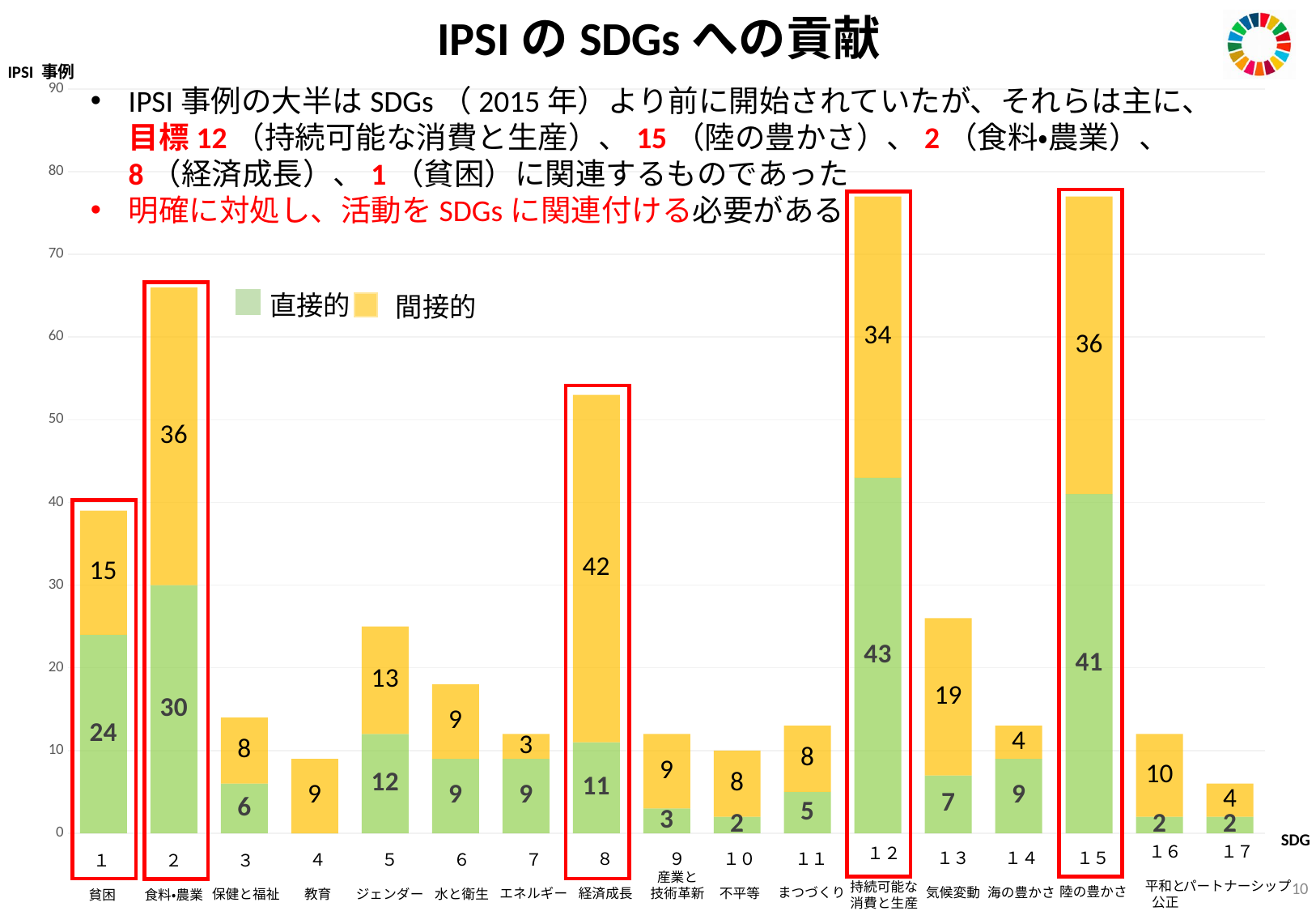
What is the total of the stacked bar for SDG 15 (陸の豊かさ)? 77 What is the 直接的 value for SDG 12 (持続可能な消費と生産)? 43 What is the 間接的 value for SDG 8 (経済成長)? 42 How many series does the legend list? 2 What is the total of the stacked bar for SDG 2 (食料•農業)? 66 What is the 直接的 value for SDG 1 (貧困)? 24 Which is larger for SDG 13 (気候変動): the 直接的 value or the 間接的 value? 間接的 Which SDG has the highest 間接的 value? 8 (経済成長) What is the difference between the 間接的 and 直接的 values for SDG 8 (経済成長)? 31 How many SDG categories are shown on the x axis? 17 Which SDG has the highest 直接的 value? 12 (持続可能な消費と生産) What kind of chart is shown on the slide? Stacked bar chart